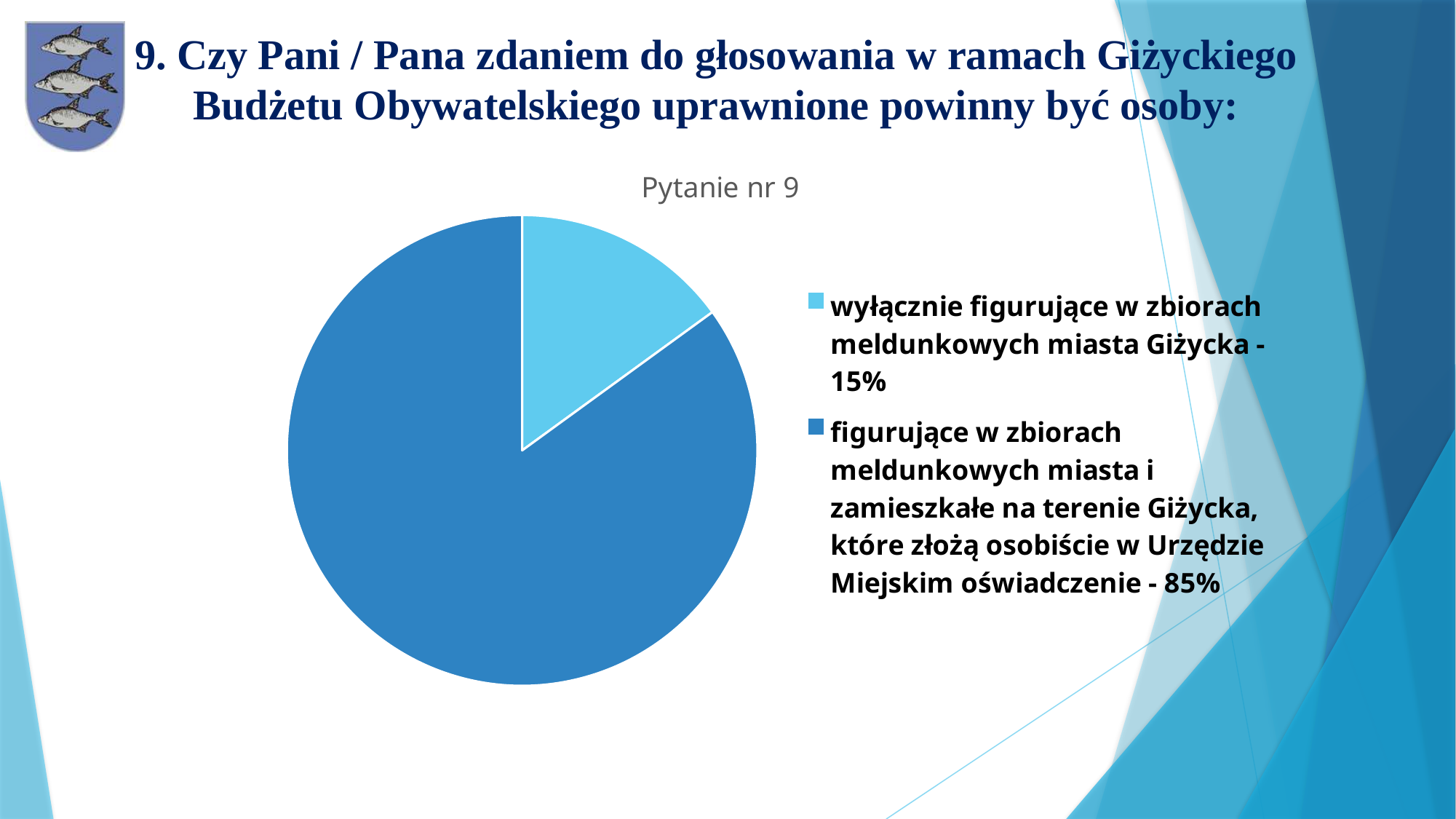
What share of the pie is for 'wyłącznie figurujące w zbiorach meldunkowych miasta Giżycka'? 15% What is the total of the two percentages shown in the legend? 100% Which category has the largest slice of the pie? figurujące w zbiorach meldunkowych miasta i zamieszkałe na terenie Giżycka, które złożą osobiście w Urzędzie Miejskim oświadczenie How many entries does the legend list? 2 What colour is the slice for 'wyłącznie figurujące w zbiorach meldunkowych miasta Giżycka'? light blue Which category has the smallest slice of the pie? wyłącznie figurujące w zbiorach meldunkowych miasta Giżycka Which is larger: the slice for 'wyłącznie figurujące w zbiorach meldunkowych miasta Giżycka' or the slice for 'figurujące w zbiorach meldunkowych miasta i zamieszkałe na terenie Giżycka, które złożą osobiście w Urzędzie Miejskim oświadczenie'? figurujące w zbiorach meldunkowych miasta i zamieszkałe na terenie Giżycka, które złożą osobiście w Urzędzie Miejskim oświadczenie What share of the pie is for 'figurujące w zbiorach meldunkowych miasta i zamieszkałe na terenie Giżycka, które złożą osobiście w Urzędzie Miejskim oświadczenie'? 85% How many slices does the pie chart have? 2 What is the difference in percentage points between the two slices of the pie? 70 What kind of chart is shown on the slide? pie chart What is the title of the chart? Pytanie nr 9